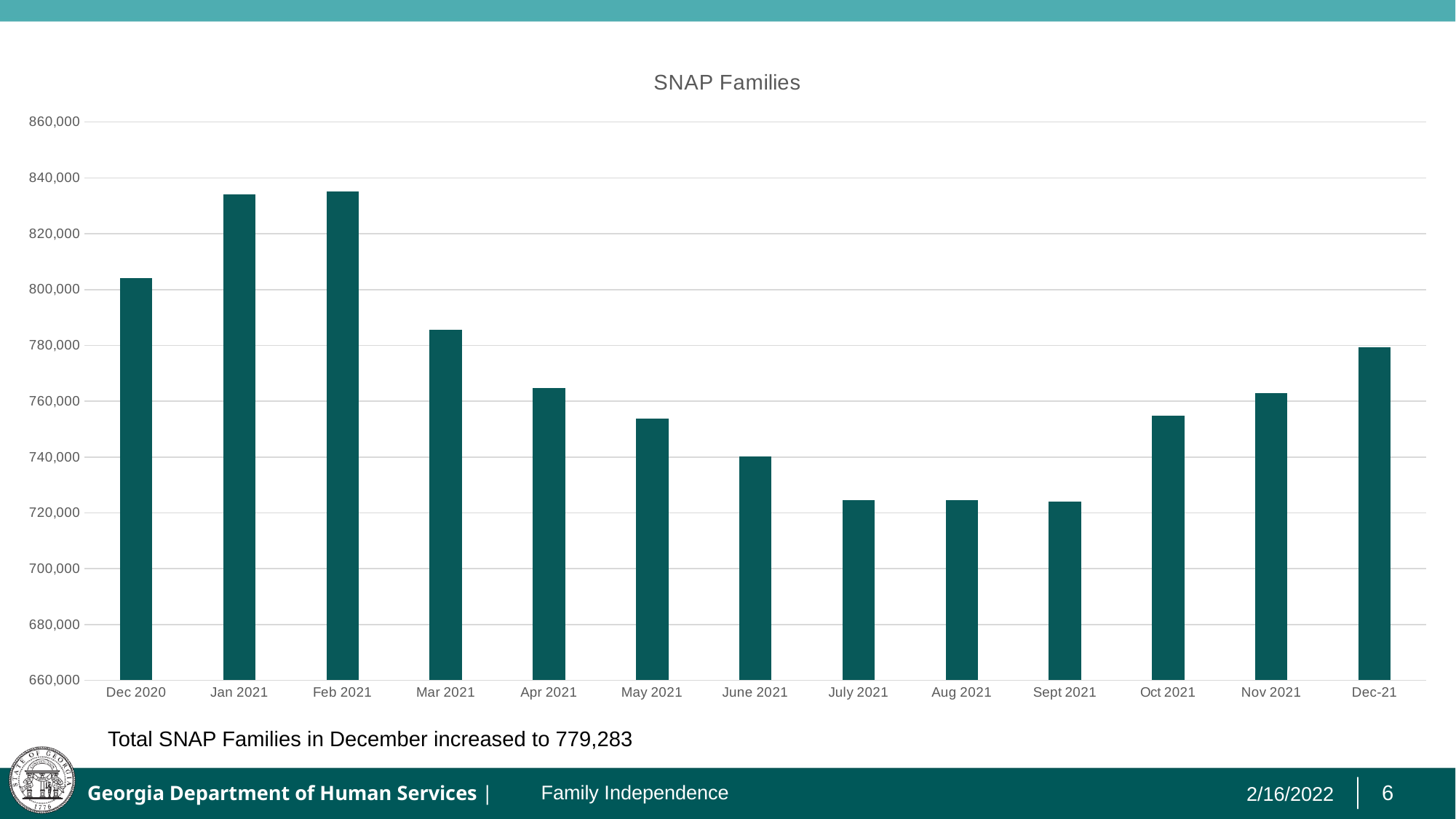
Is the value for Nov 2021 greater or less than 740,000? greater Which is larger, the value for Jan 2021 or the value for Mar 2021? Jan 2021 Which is larger, the value for Dec 2020 or the value for Dec-21? Dec 2020 Is the value for July 2021 greater or less than 740,000? less Is the value for Mar 2021 greater or less than 800,000? less What is the title of the chart? SNAP Families How many months are plotted on the chart? 13 Do the values rise or fall from Feb 2021 to Sept 2021? fall According to the slide, what was the total number of SNAP Families in December 2021 (Dec-21)? 779,283 What kind of chart is shown on the slide? bar chart